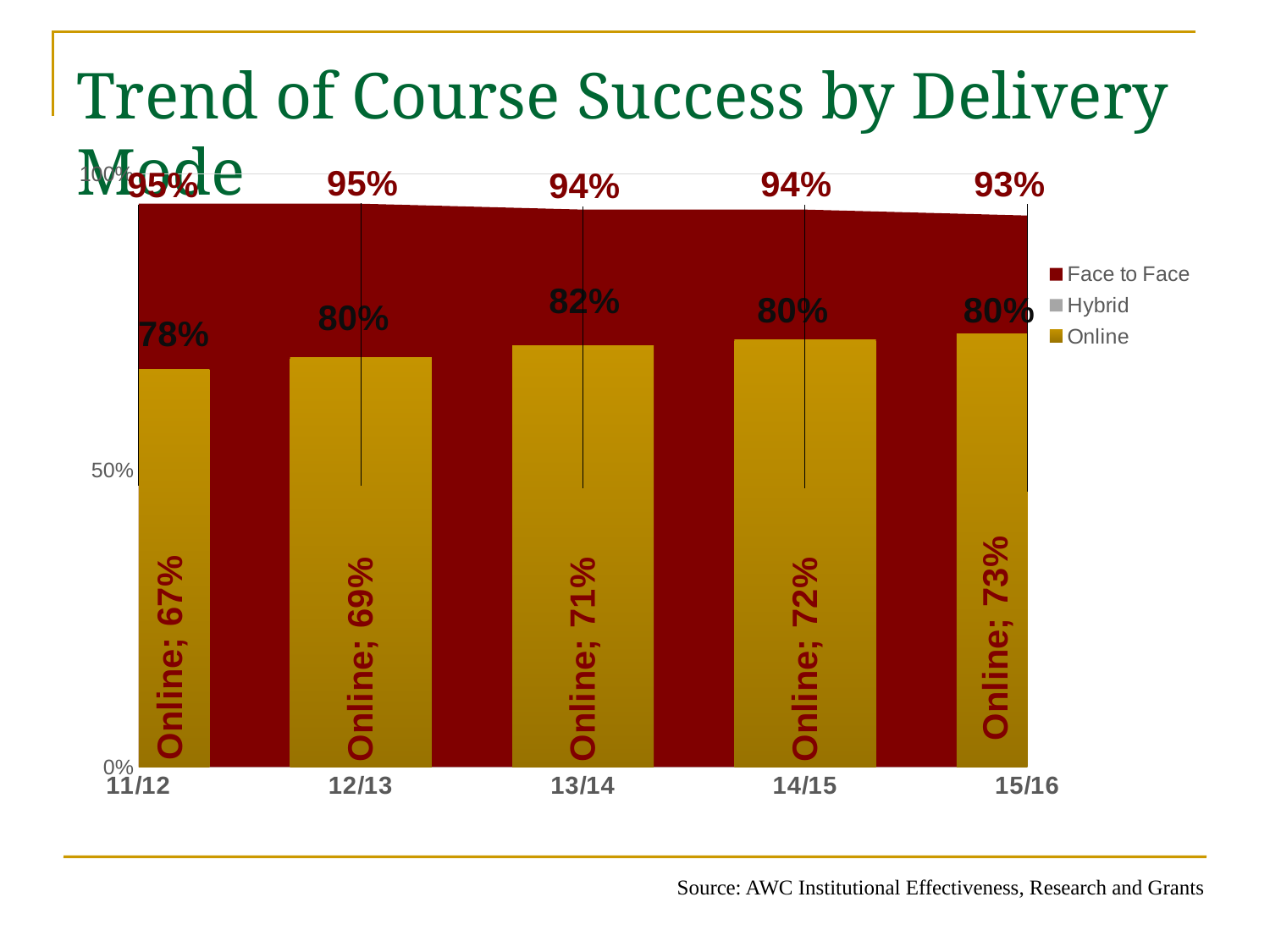
In which year is the Online success rate highest? 15/16 Does the Face to Face success rate rise or fall from 11/12 to 15/16? fall Which year has the higher Online success rate, 12/13 or 14/15? 14/15 How many academic years are shown on the x axis? 5 Does the Online success rate rise or fall from 11/12 to 15/16? rise In which year is the Face to Face success rate lowest? 15/16 What is the Online course success rate for 11/12? 67% What is the Online course success rate for 15/16? 73% What is the Face to Face course success rate for 15/16? 93% What is the difference between the Face to Face and Online success rates in 11/12? 28% How many series does the legend list? 3 What is the Face to Face course success rate for 13/14? 94%